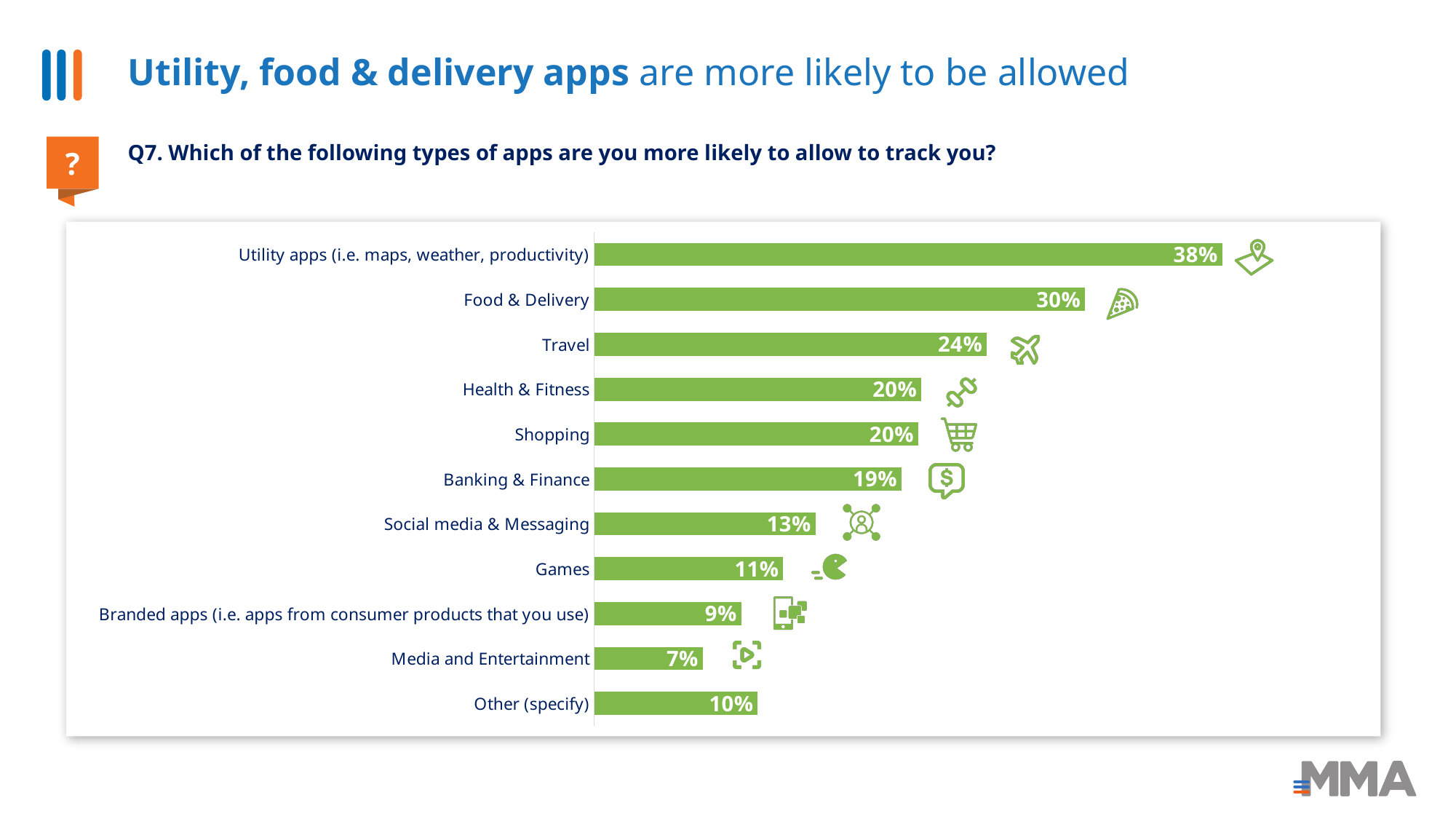
Which type of app has the highest percentage? Utility apps (i.e. maps, weather, productivity) How many app categories are shown in the chart? 11 Which type of app has the lowest percentage? Media and Entertainment What is the difference between the values for Travel and Games? 13% What colour are the bars in the chart? Green What is the value shown for Banking & Finance? 19% Which has a larger value, Social media & Messaging or Branded apps? Social media & Messaging What is the value shown for Food & Delivery? 30% What kind of chart is shown on the slide? Bar chart What is the value shown for Media and Entertainment? 7% What percentage of respondents are more likely to allow Utility apps to track them? 38% What is the difference between the values for Utility apps and Food & Delivery? 8%